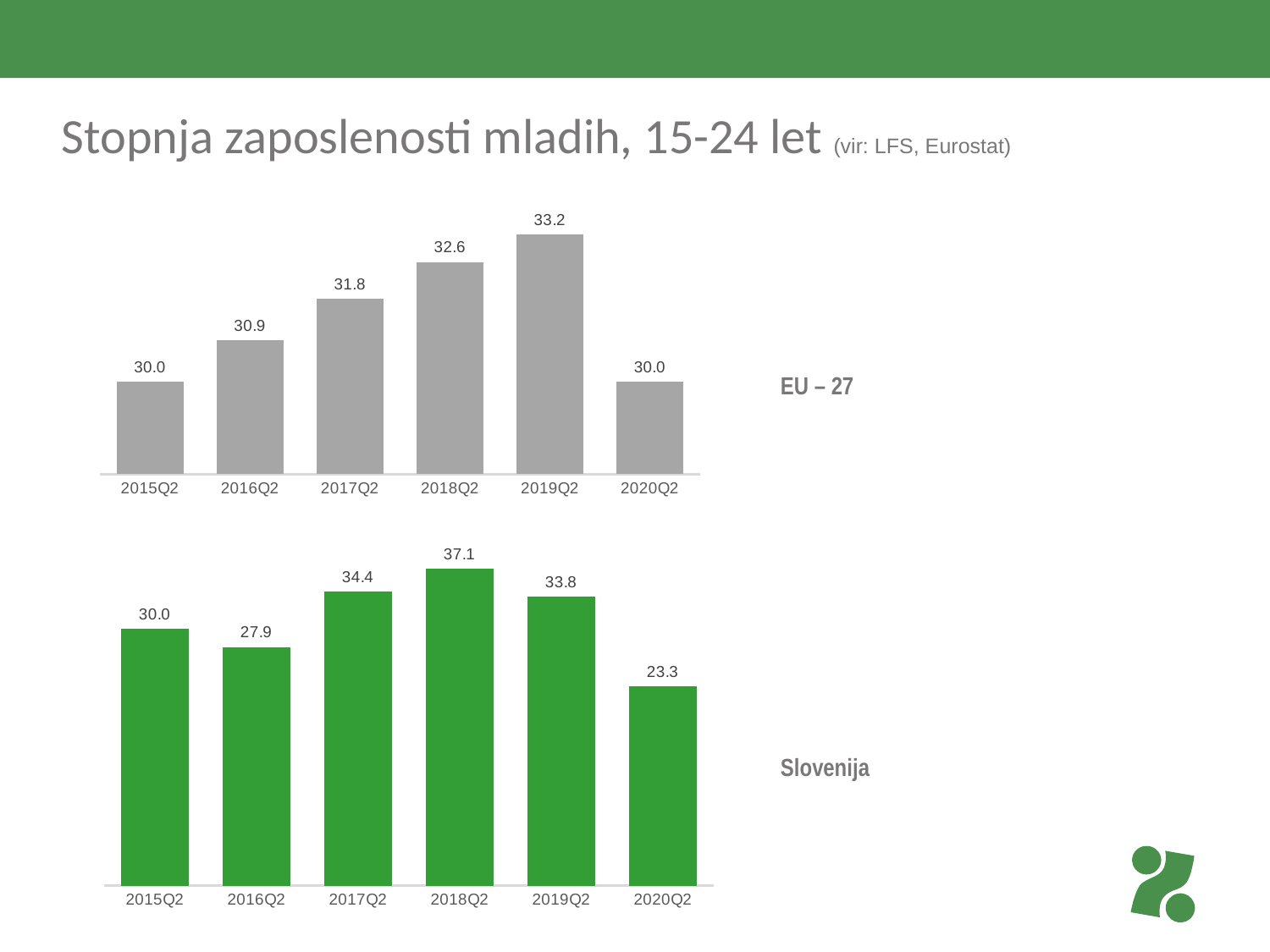
What colour are the bars in the Slovenija chart (bottom)? Green In the EU – 27 chart (top), what is the value for 2018Q2? 32.6 What kind of chart is the Slovenija chart (bottom)? Bar chart How many periods are shown on the x axis of the EU – 27 chart (top)? 6 In the EU – 27 chart (top), what is the difference between the 2019Q2 and 2015Q2 values? 3.2 In the Slovenija chart (bottom), what is the difference between the 2018Q2 and 2020Q2 values? 13.8 In the Slovenija chart (bottom), which period has the highest value? 2018Q2 In the EU – 27 chart (top), which period has the highest value? 2019Q2 In the Slovenija chart (bottom), what is the value for 2016Q2? 27.9 In the EU – 27 chart (top), do the values rise or fall from 2015Q2 to 2019Q2? Rise In the Slovenija chart (bottom), which is larger, the value for 2017Q2 or the value for 2019Q2? 2017Q2 In the Slovenija chart (bottom), which period has the lowest value? 2020Q2